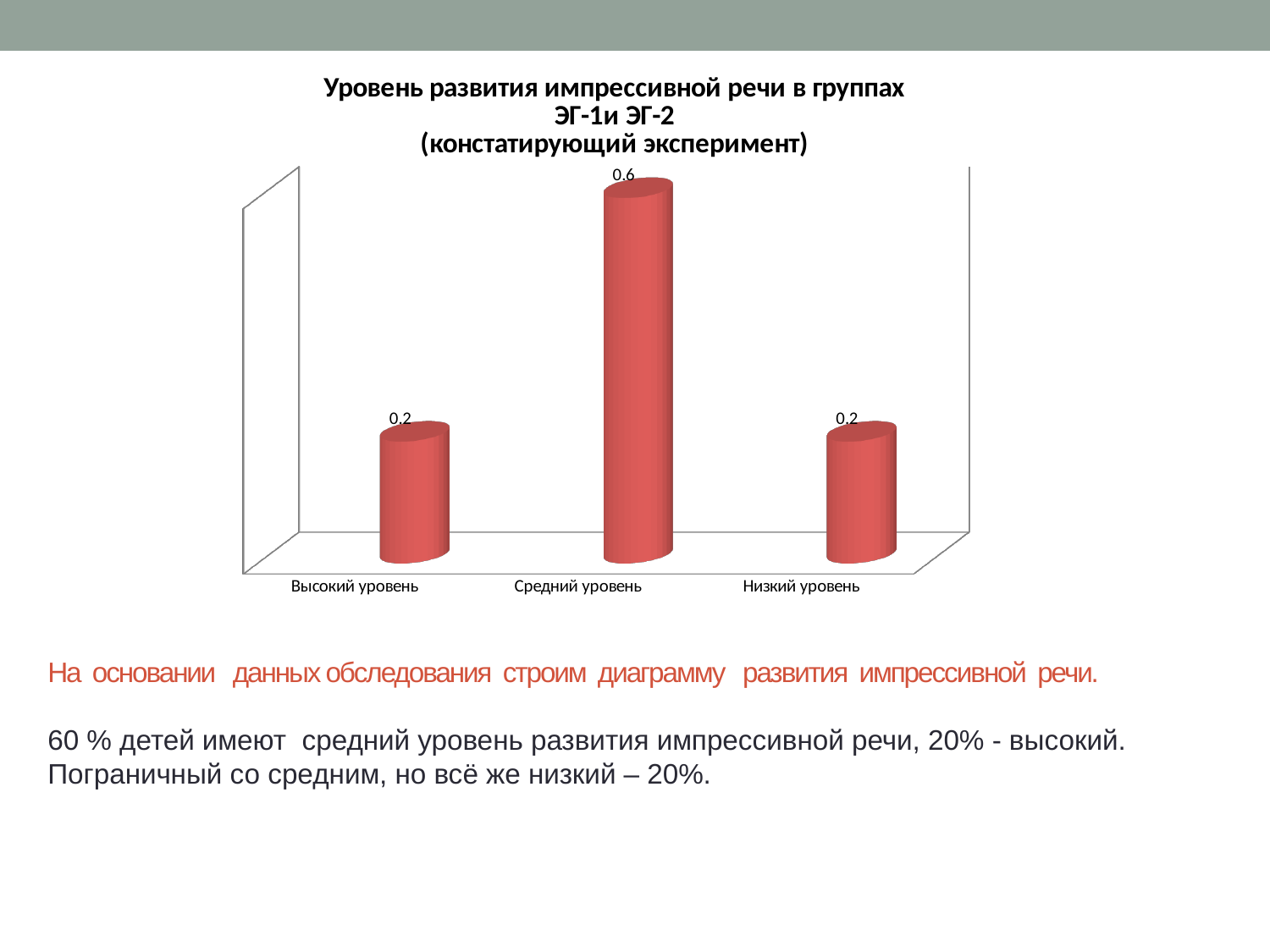
What is the value for Средний уровень? 0.6 Which is larger, the value for Средний уровень or the value for Низкий уровень? Средний уровень What kind of chart is shown on the slide? bar chart What is the value for Высокий уровень? 0.2 What is the title of the chart? Уровень развития импрессивной речи в группах ЭГ-1и ЭГ-2 (констатирующий эксперимент) How many categories are shown on the x axis? 3 What is the difference between the values for Средний уровень and Высокий уровень? 0.4 What is the value for Низкий уровень? 0.2 Which category has the highest value? Средний уровень What colour are the bars in the chart? red What is the total of the three plotted values? 1.0